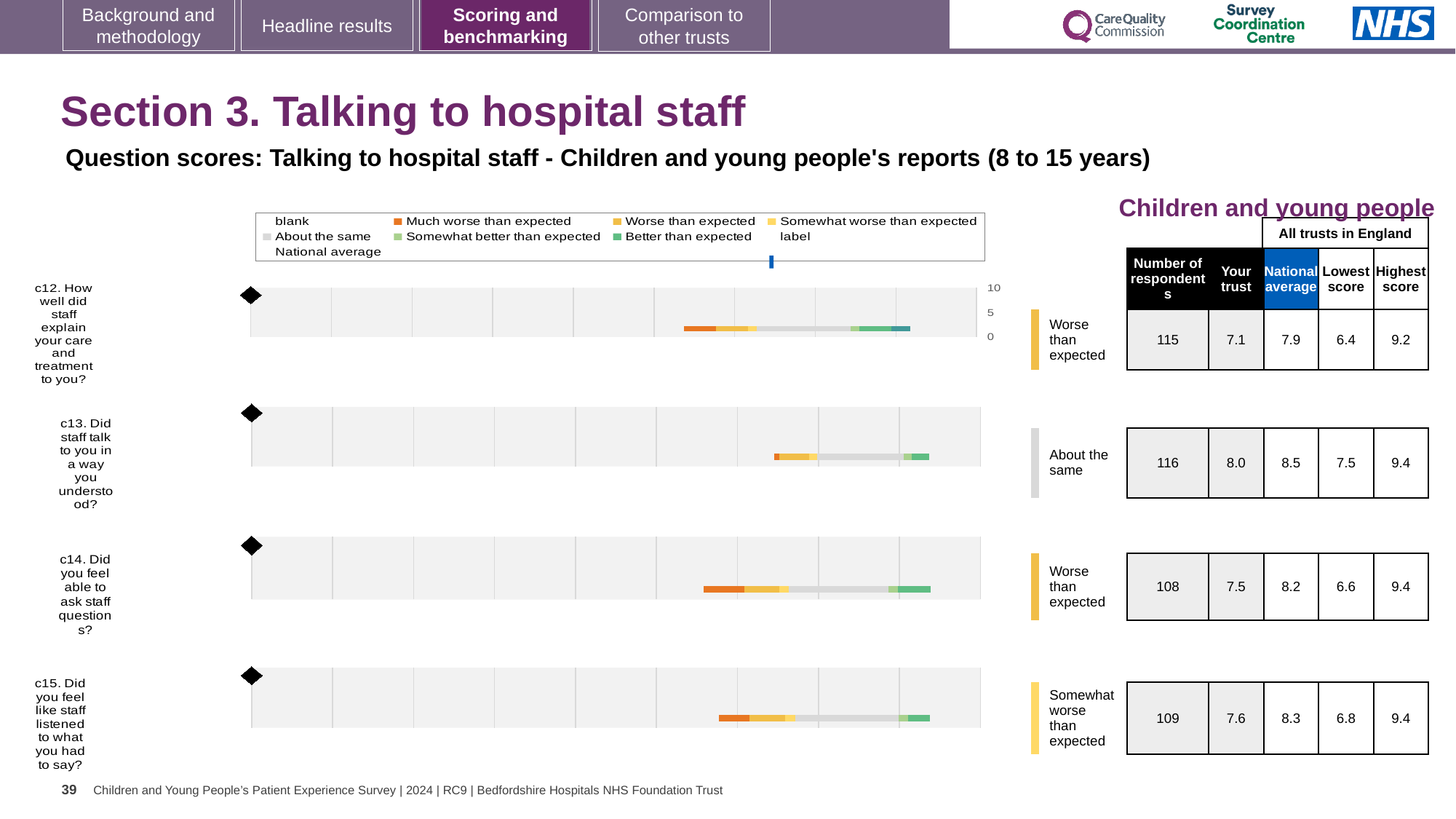
What is the highest score across all trusts in England for c12? 9.2 How many respondents answered c14 (Did you feel able to ask staff questions?)? 108 What is the national average score for c12 (How well did staff explain your care and treatment to you?)? 7.9 For c13, how much higher is the national average than the 'Your trust' score? 0.5 How many questions (c12 to c15) are plotted in the chart? 4 Which has the larger 'Your trust' score, c14 or c15? c15 Which question has the highest 'Your trust' score? c13 What is the 'Your trust' score for c13 (Did staff talk to you in a way you understood?)? 8.0 What benchmark category is shown for c13? About the same Which question has the lowest 'Your trust' score? c12 What kind of chart is used to show the question scores for c12 to c15? Bar chart What is the lowest score across all trusts in England for c15? 6.8